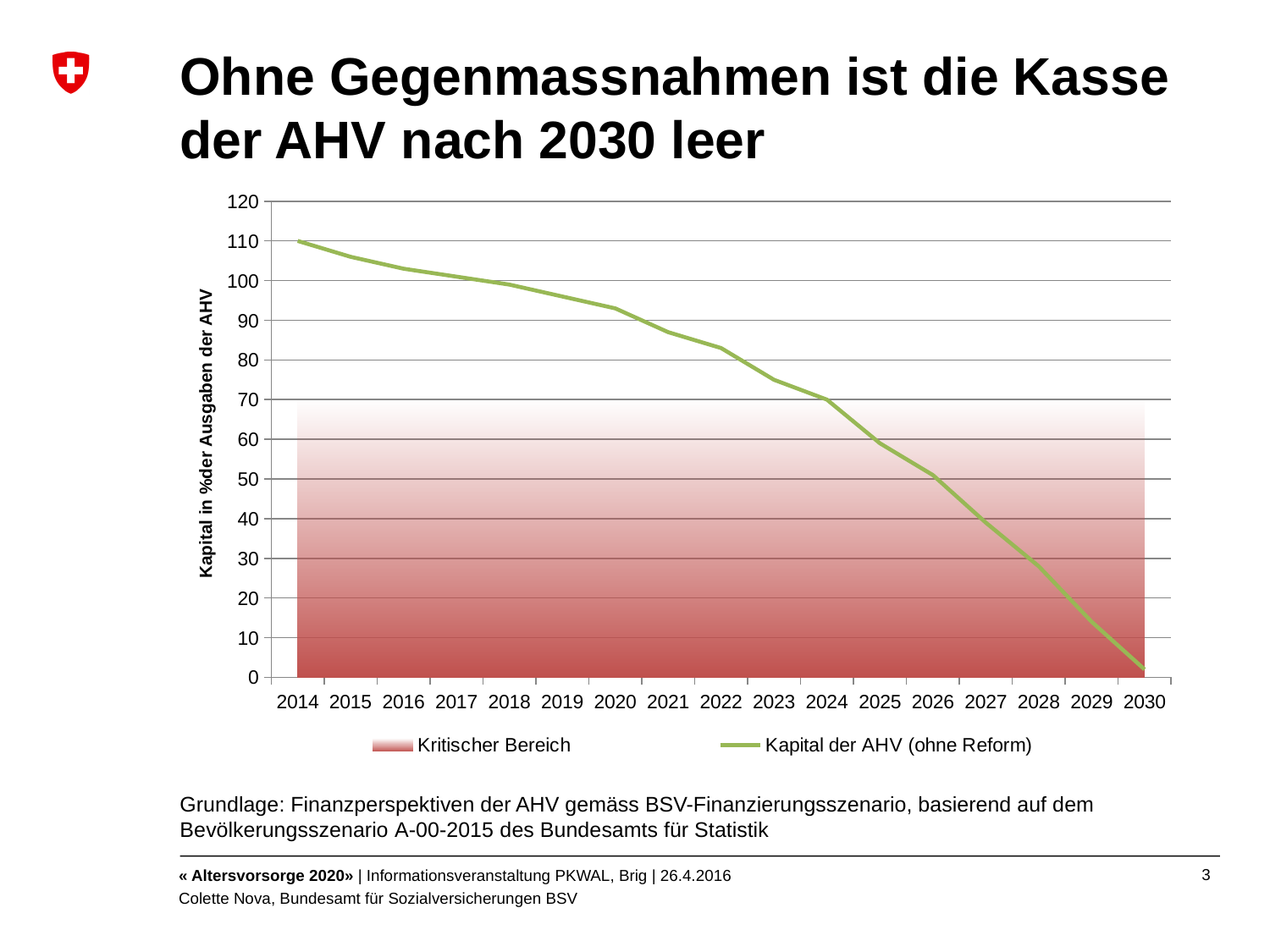
What is the label of the y axis of the chart? Kapital in % der Ausgaben der AHV What kind of chart is shown on the slide? line chart Is the 'Kapital der AHV (ohne Reform)' value for 2028 greater or less than 40? less In which year is the 'Kapital der AHV (ohne Reform)' value highest? 2014 Is the 'Kapital der AHV (ohne Reform)' value for 2030 greater or less than 10? less What is the name of the shaded area series in the chart legend? Kritischer Bereich Is the 'Kapital der AHV (ohne Reform)' value for 2020 greater or less than 90? greater How many series does the chart legend list? 2 Which year has the larger 'Kapital der AHV (ohne Reform)' value, 2018 or 2026? 2018 How many years are shown along the x axis of the chart? 17 Does the 'Kapital der AHV (ohne Reform)' line rise or fall from 2014 to 2030? fall In which year is the 'Kapital der AHV (ohne Reform)' value lowest? 2030